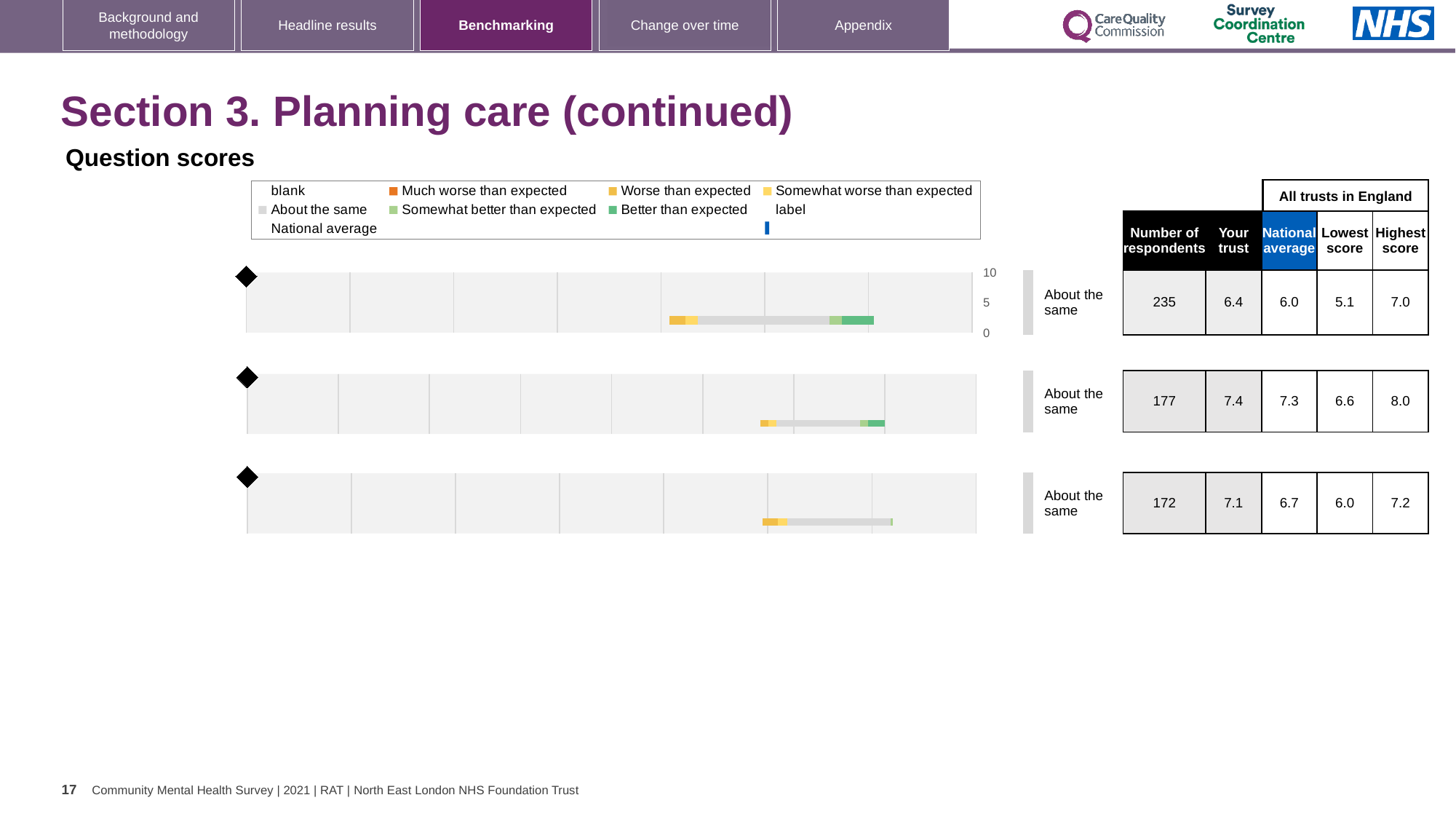
For the top chart, what is the 'Your trust' score? 6.4 For the bottom chart, what is the highest score among all trusts in England? 7.2 What benchmark category is shown next to each of the three charts? About the same How many question score charts are shown on the slide? 3 For the bottom chart, what is the difference between the highest score and the lowest score? 1.2 For the top chart, what is the national average score? 6.0 Which chart (top, middle or bottom) has the lowest 'Lowest score' value? top For the top chart, what is the difference between the 'Your trust' score and the national average? 0.4 For the middle chart, which is larger: the 'Your trust' score or the national average? Your trust Which chart (top, middle or bottom) has the highest 'Your trust' score? middle For the middle chart, what is the number of respondents? 177 What kind of chart is used on this slide to show the question scores? bar chart